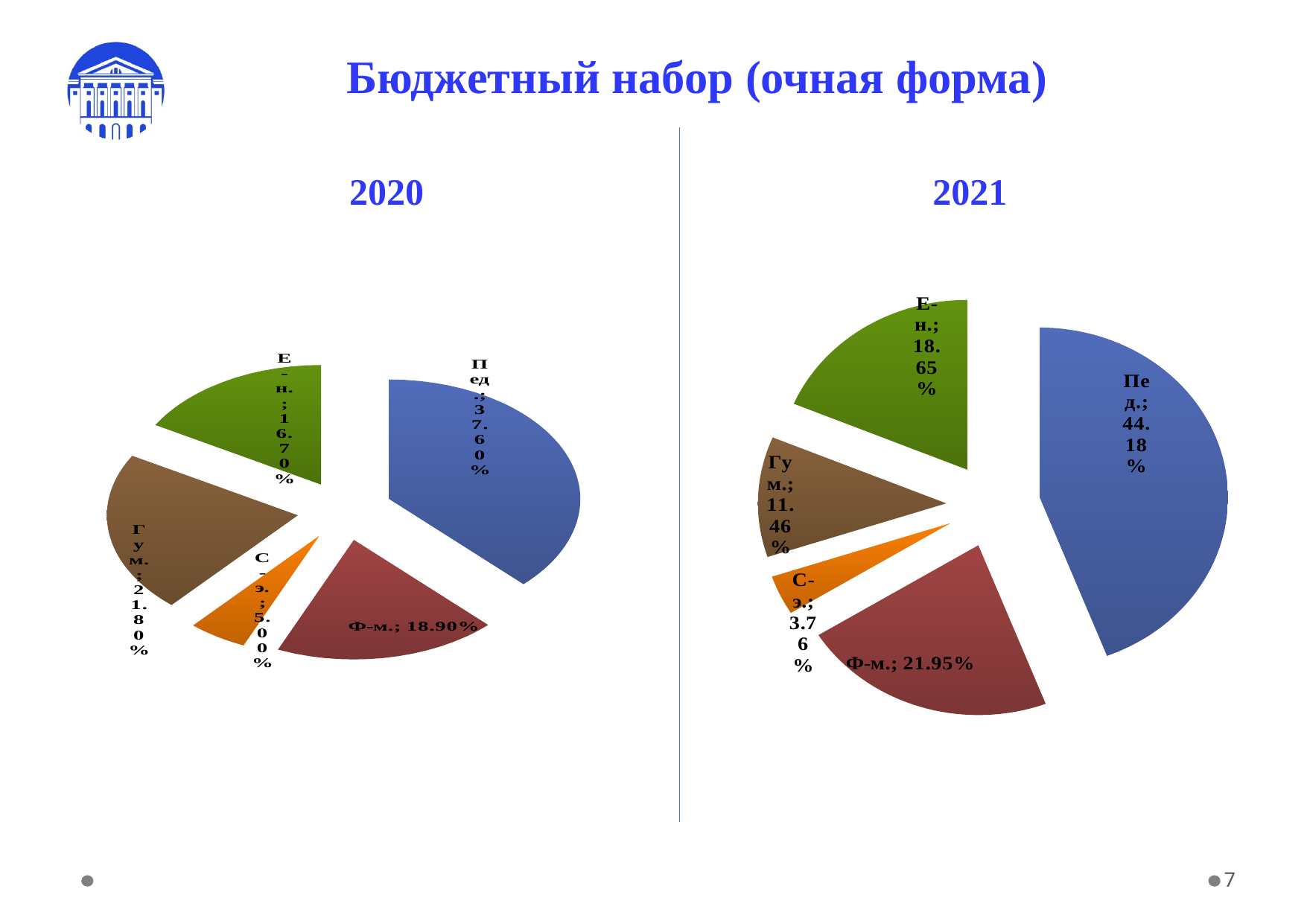
In the 2021 pie chart, which is larger: Е-н. or Гум.? Е-н. In the 2021 pie chart, what is the value for Гум.? 11.46% What type of chart is used for the 2021 data? Pie chart In the 2021 pie chart, what share does Пед. have? 44.18% How many slices does the 2020 pie chart have? 5 In the 2020 pie chart, which category has the largest share? Пед. In the 2020 pie chart, what is the value for Ф-м.? 18.90% In the 2020 pie chart, which category has the smallest share? С-э. In the 2021 pie chart, what is the value for С-э.? 3.76% In the 2020 pie chart, what share does Пед. have? 37.60% In the 2021 pie chart, which category has the smallest share? С-э. What is the difference between the Пед. share in 2021 and in 2020? 6.58%